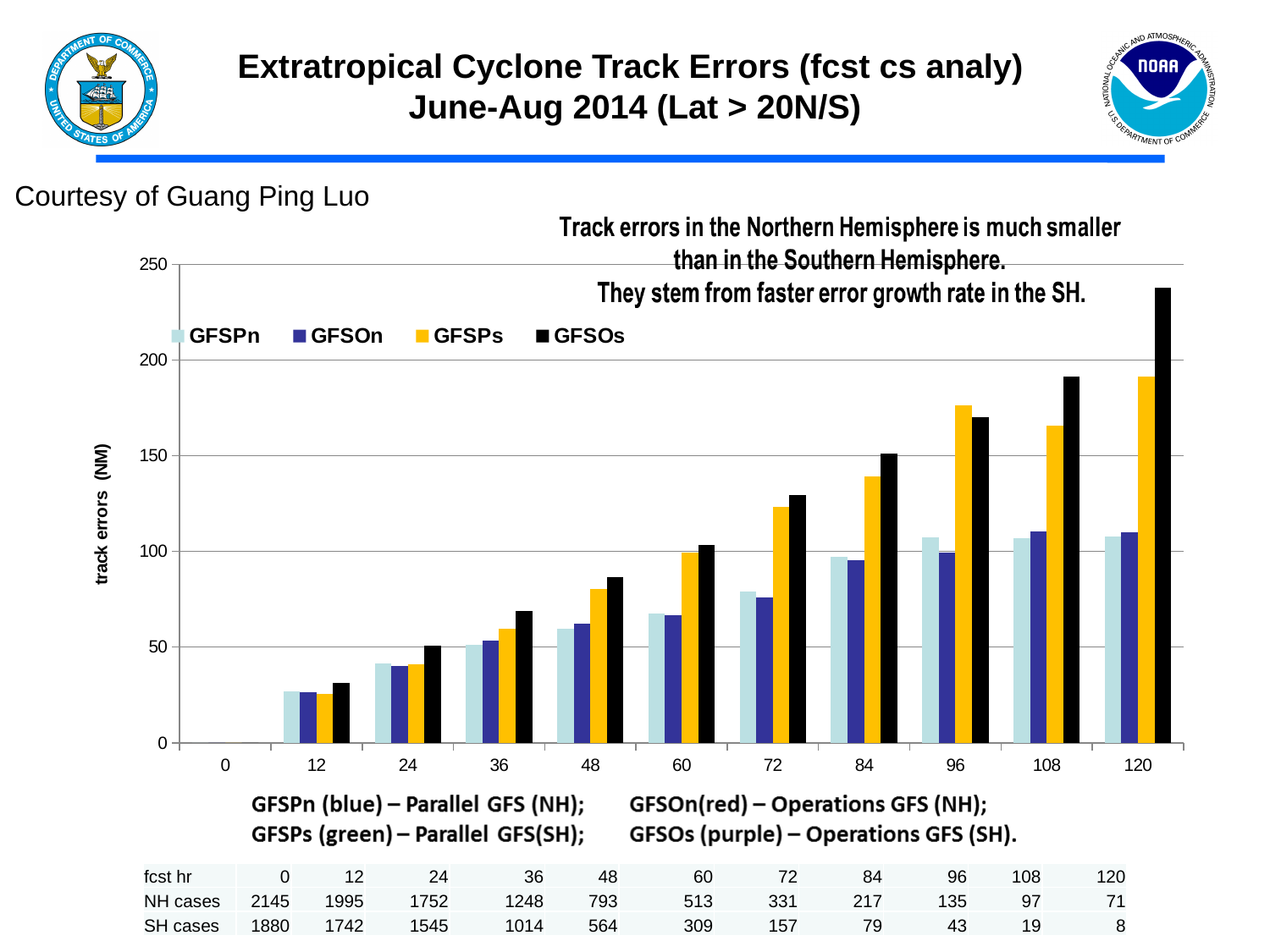
At forecast hour 72, which is larger: GFSPs or GFSPn? GFSPs How many series does the chart legend list? 4 Is the GFSOn value at forecast hour 60 greater or less than 100? less Is the GFSOs value at forecast hour 120 greater or less than 200? greater At forecast hour 120, which is larger: GFSOs or GFSPs? GFSOs What is the label on the y axis of the chart? track errors (NM) How many forecast-hour categories are shown along the x axis? 11 Is the GFSPn value at forecast hour 12 greater or less than 50? less What kind of chart is shown on the slide? bar chart Do the GFSOs values rise or fall as the forecast hour increases? rise At which forecast hour is the GFSOs bar highest? 120